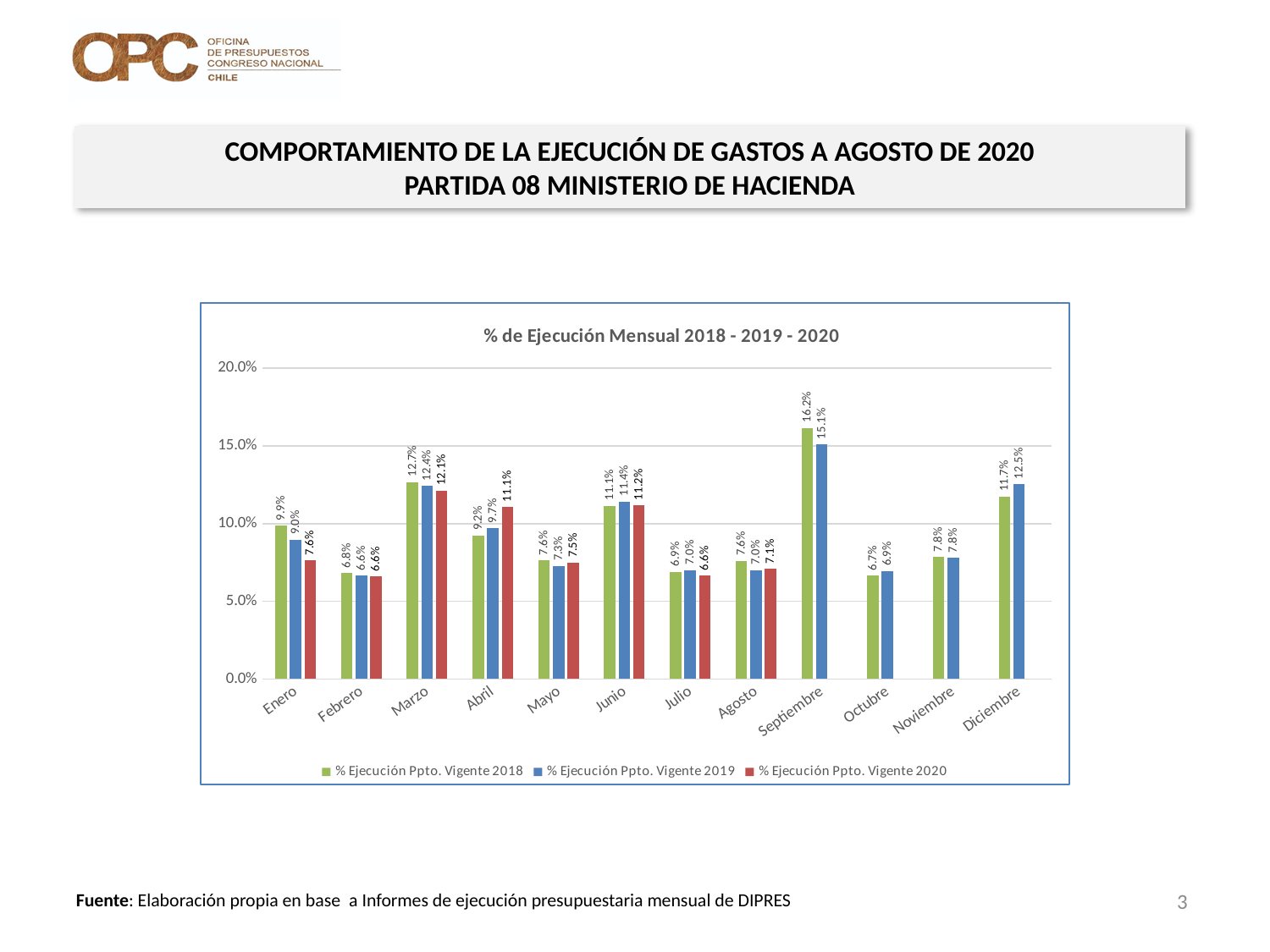
Which is larger in Abril: the 2018 value or the 2020 value? 2020 value Is the value for % Ejecución Ppto. Vigente 2018 in Septiembre greater or less than 15.0%? greater What is the value for % Ejecución Ppto. Vigente 2020 in Marzo? 12.1% How many months are shown on the x axis? 12 What type of chart is shown on the slide? bar chart What is the value for % Ejecución Ppto. Vigente 2019 in Septiembre? 15.1% Which month has the lowest value for % Ejecución Ppto. Vigente 2020? Febrero and Julio (6.6%) What is the title of the chart? % de Ejecución Mensual 2018 - 2019 - 2020 What is the value for % Ejecución Ppto. Vigente 2018 in Diciembre? 11.7% How many series does the legend list? 3 Which month has the highest value for % Ejecución Ppto. Vigente 2018? Septiembre What is the difference between the 2018 and 2019 values in Septiembre? 1.1%